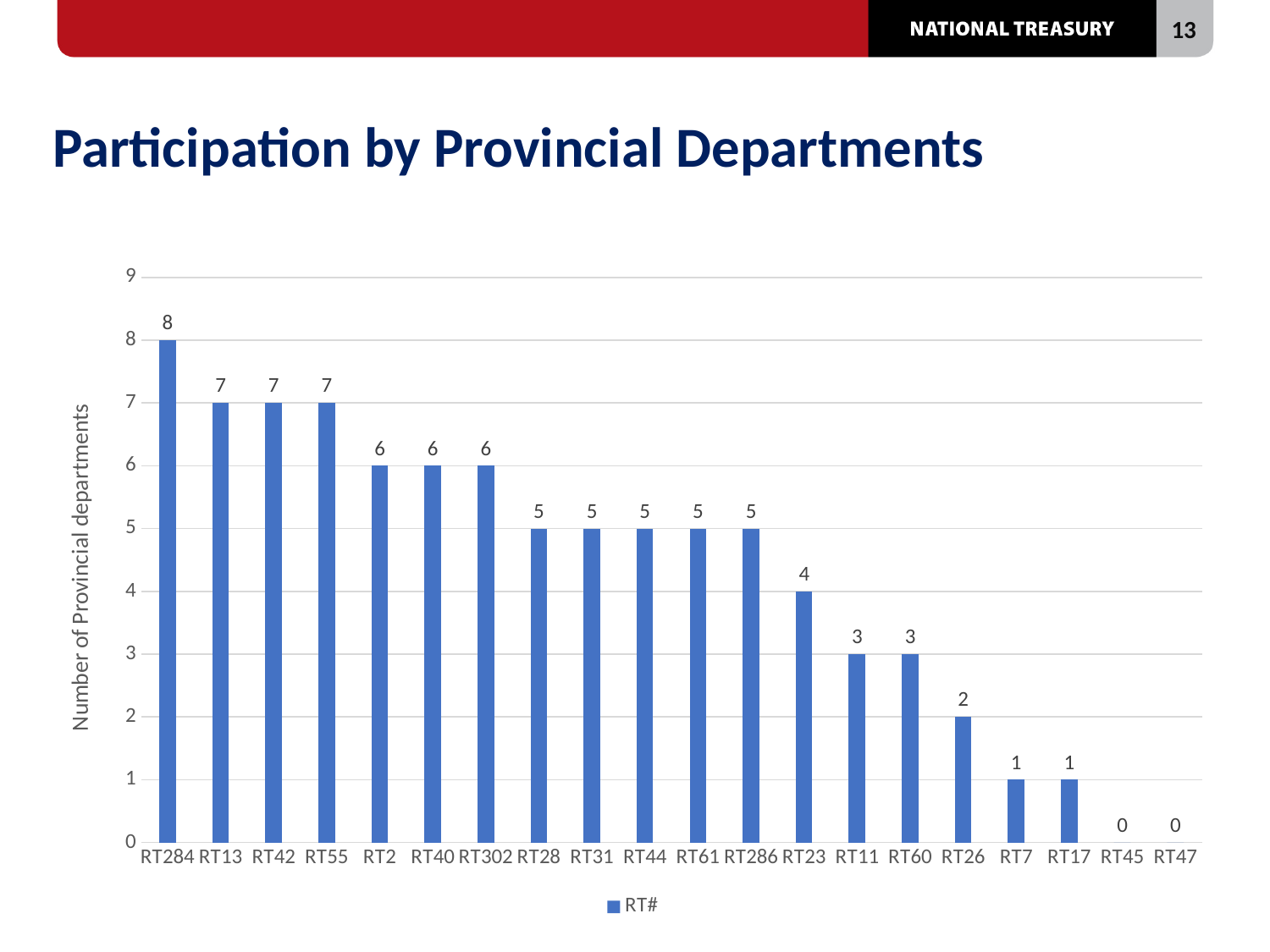
What is the value for RT284? 8 Which is larger, the value for RT2 or the value for RT11? RT2 How many series does the legend list? 1 What is the value for RT26? 2 What is the value for RT302? 6 How many categories are shown on the x axis? 20 Which category has the highest value? RT284 What is the difference between the values for RT13 and RT60? 4 What is the difference between the values for RT284 and RT23? 4 What kind of chart is shown? Bar chart What is the label of the y axis? Number of Provincial departments What is the value for RT23? 4